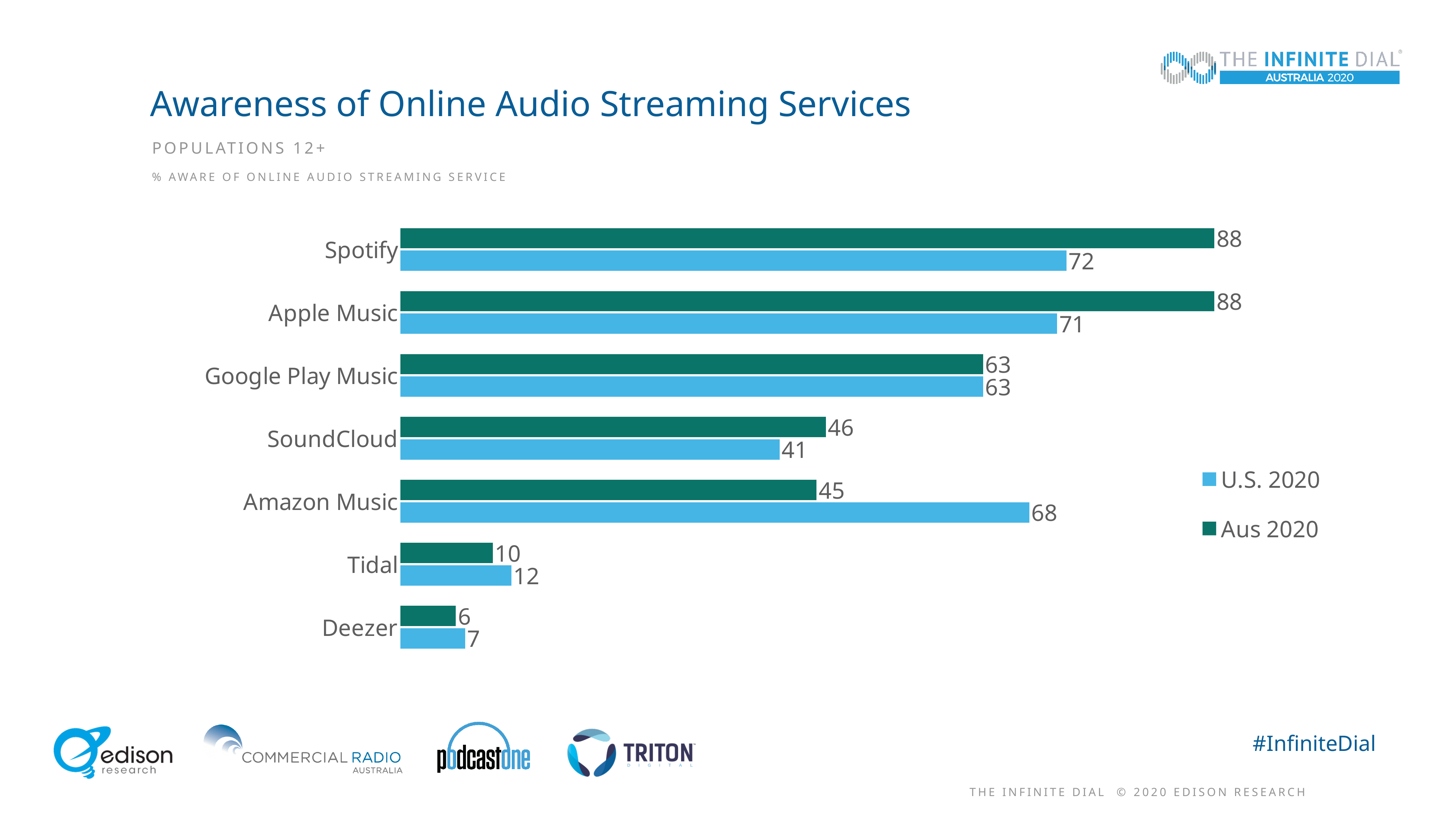
How many series does the legend list? 2 What is the U.S. 2020 value for SoundCloud? 41 What is the Aus 2020 value for Tidal? 10 What is the U.S. 2020 value for Amazon Music? 68 Which service has the highest U.S. 2020 value? Spotify What is the Aus 2020 value for Spotify? 88 What kind of chart is shown on the slide? Bar chart Which is larger for Apple Music, the Aus 2020 value or the U.S. 2020 value? Aus 2020 Which service has the lowest Aus 2020 value? Deezer What is the difference between the Aus 2020 and U.S. 2020 values for Amazon Music? 23 What is the difference between the Aus 2020 and U.S. 2020 values for Spotify? 16 How many streaming services are shown on the chart? 7